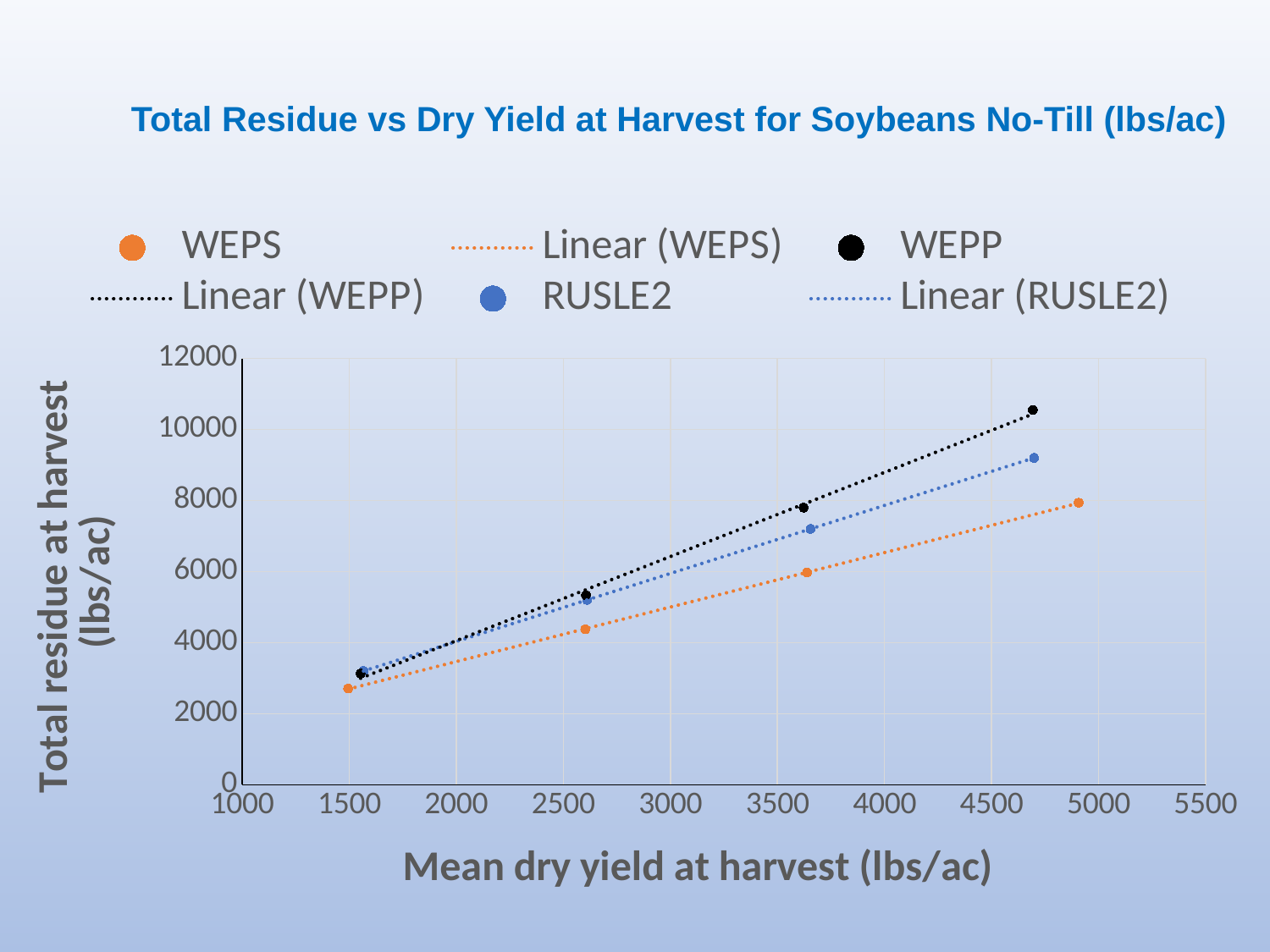
At the highest plotted yield, which series has the larger total residue, WEPP or RUSLE2? WEPP How many WEPS data points are plotted? 4 Do the total residue values rise or fall as mean dry yield increases? Rise How many entries does the legend list? 6 What is the label of the x axis? Mean dry yield at harvest (lbs/ac) Is the lowest WEPS data point greater or less than 4000 lbs/ac of total residue? less Is the highest RUSLE2 data point greater or less than 8000 lbs/ac of total residue? greater Which series has the lowest total residue at the highest yields? WEPS What kind of chart is shown on the slide? Scatter chart with linear trendlines Is the highest WEPP data point greater or less than 10000 lbs/ac of total residue? greater Which series reaches the highest total residue at harvest? WEPP